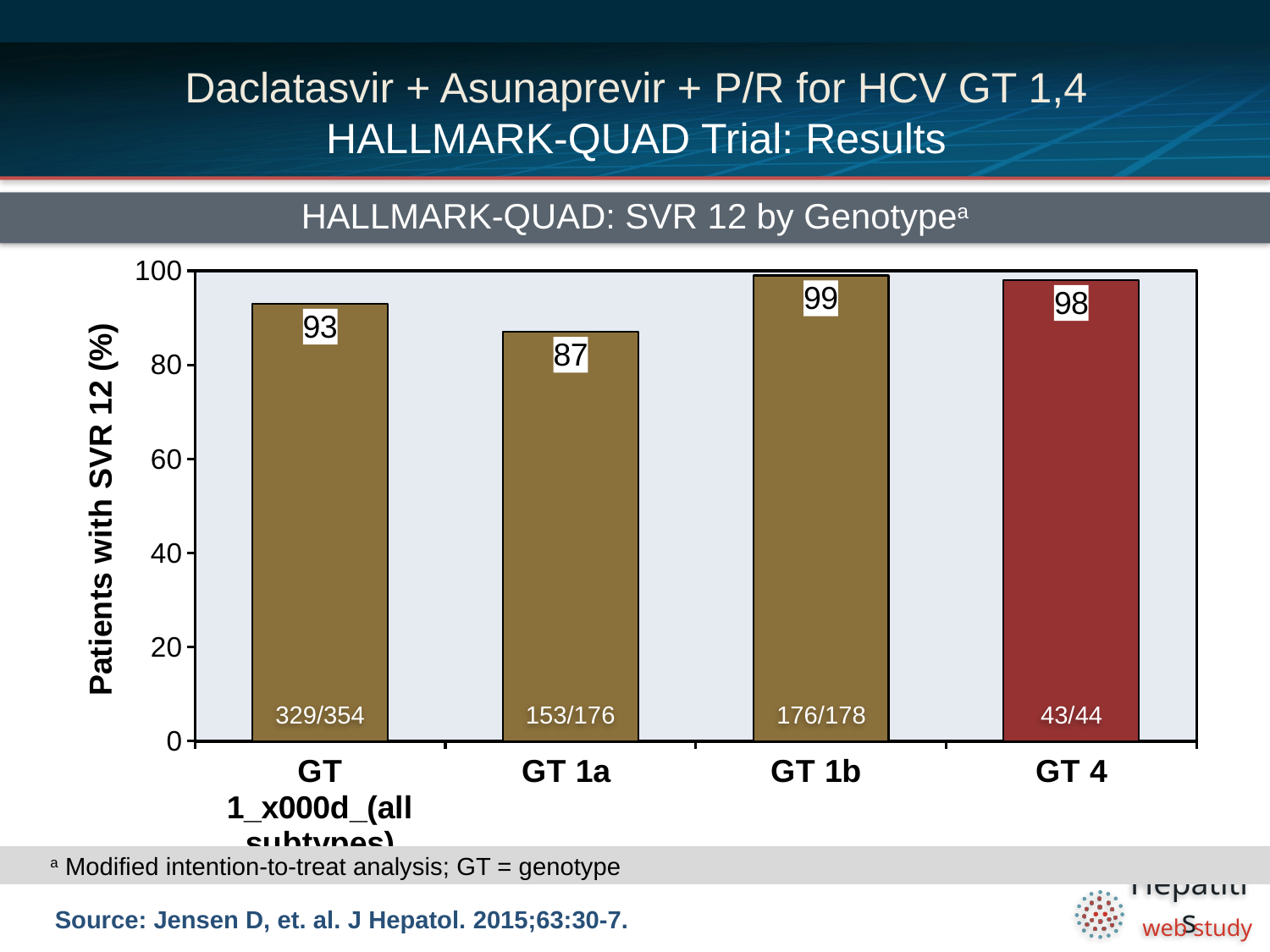
Which genotype group has the highest SVR 12 rate? GT 1b Which genotype group has the lowest SVR 12 rate? GT 1a What is the SVR 12 rate for GT 1a? 87 What is the SVR 12 rate for GT 1 (all subtypes)? 93 What kind of chart is shown on the slide? Bar chart What is the SVR 12 rate for GT 1b? 99 How many genotype groups are shown in the chart? 4 What is the difference in SVR 12 rate between GT 1b and GT 1a? 12 What is the title of the chart? HALLMARK-QUAD: SVR 12 by Genotype What is the SVR 12 rate for GT 4? 98 Which has a higher SVR 12 rate, GT 1a or GT 4? GT 4 What fraction of patients is printed on the GT 1b bar? 176/178